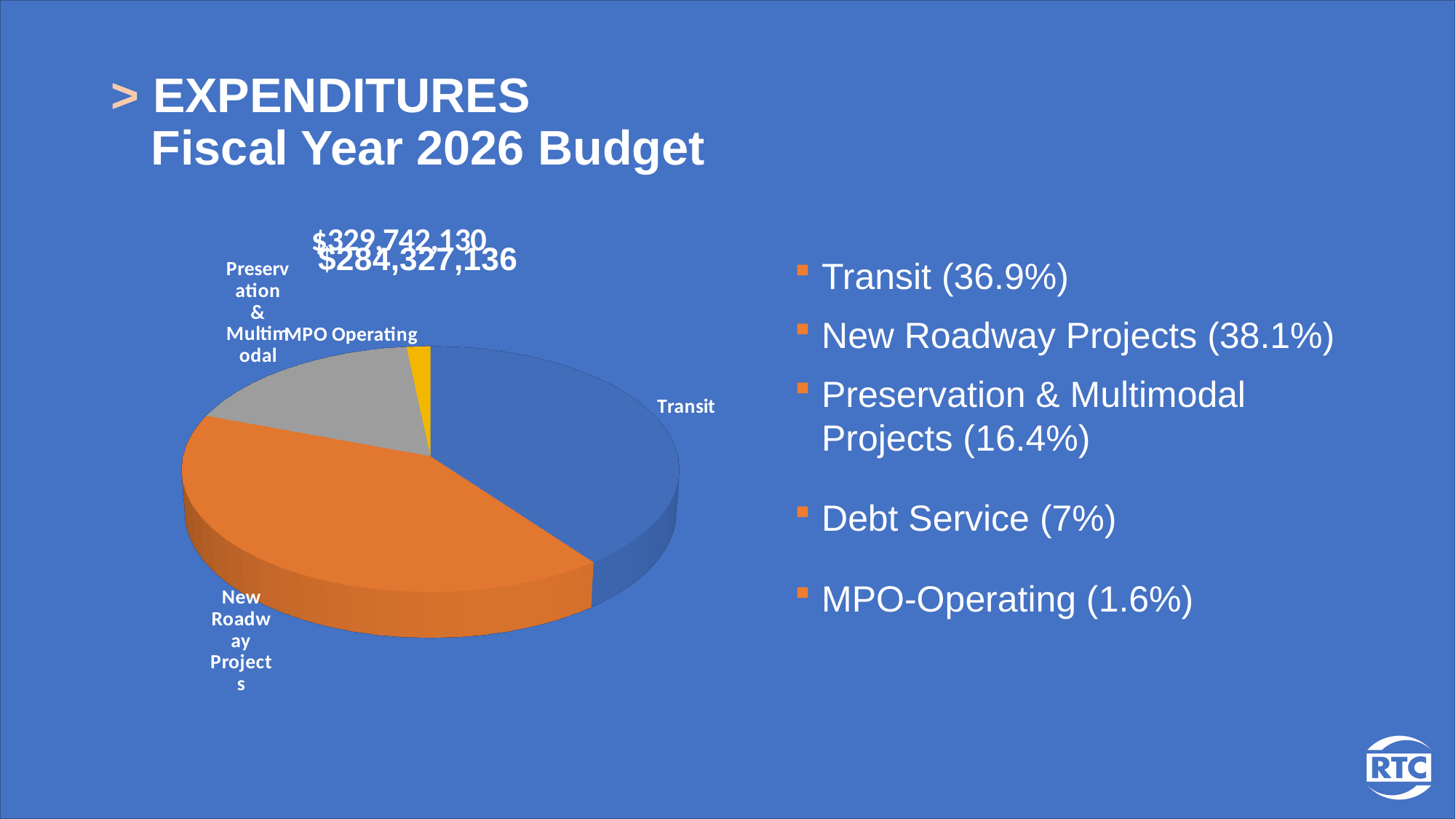
What colour is the Transit slice in the pie chart? blue According to the slide, what share of expenditures is Transit? 36.9% What colour is the New Roadway Projects slice in the pie chart? orange According to the slide, what share of expenditures is MPO-Operating? 1.6% How many labeled slices does the pie chart have? 4 What kind of chart is shown on the slide? pie chart According to the slide, what share of expenditures is Preservation & Multimodal Projects? 16.4% Which slice is larger in the pie chart, New Roadway Projects or MPO Operating? New Roadway Projects Which slice is larger in the pie chart, Transit or Preservation & Multimodal? Transit Which slice is larger in the pie chart, Preservation & Multimodal or MPO Operating? Preservation & Multimodal Which slice of the pie chart is the smallest? MPO Operating